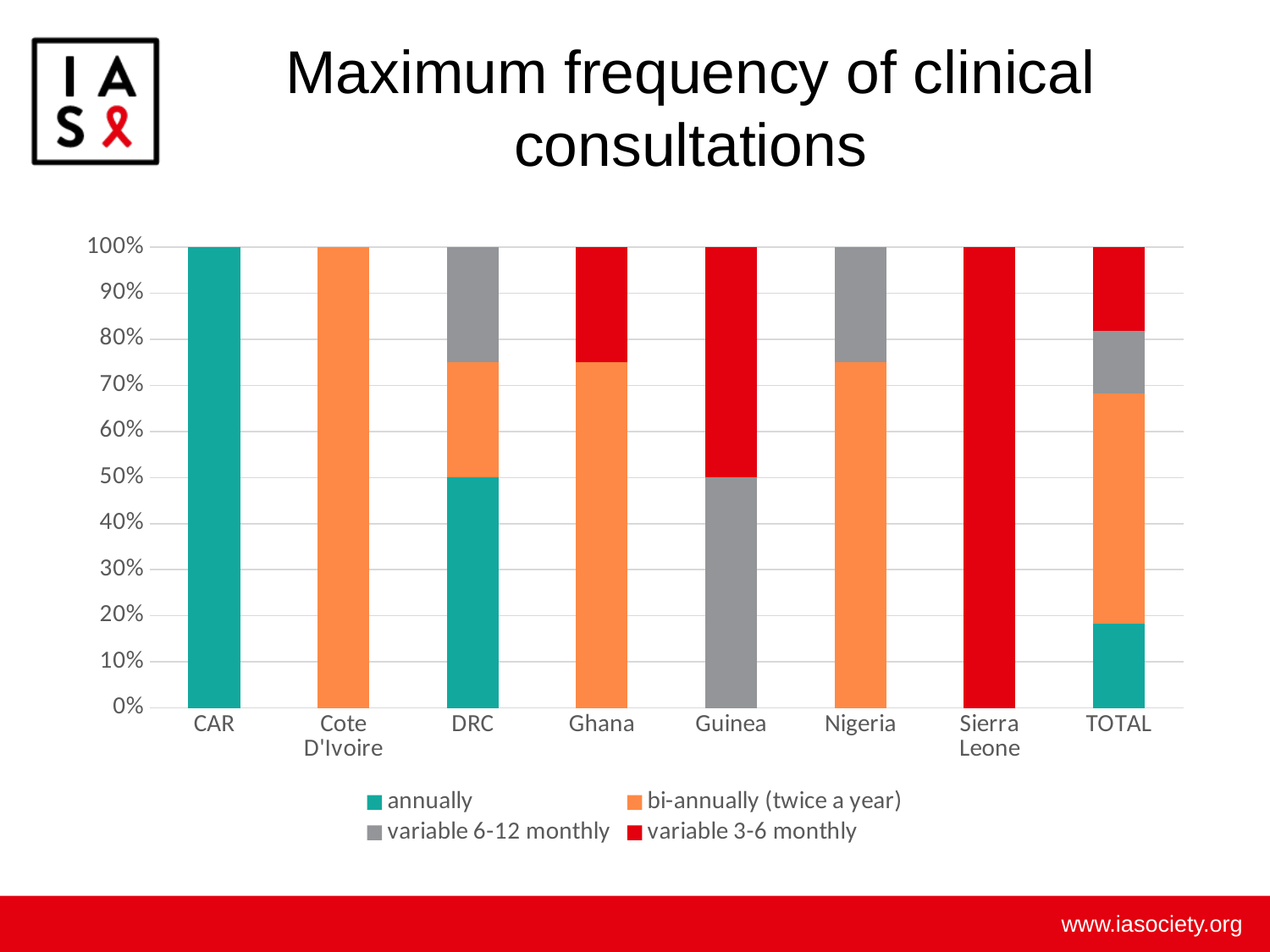
What share of Cote D'Ivoire is 'bi-annually (twice a year)'? 100% What share of Guinea is 'variable 6-12 monthly'? 50% Which country has the larger 'annually' share, CAR or DRC? CAR What kind of chart is shown on the slide? Stacked bar chart What share of DRC is 'annually'? 50% How many categories are shown along the x axis of the chart? 8 Is the 'annually' share for TOTAL greater or less than 20%? less Which series is shown in red in the chart's legend? variable 3-6 monthly How many series does the chart's legend list? 4 What is the title of the chart? Maximum frequency of clinical consultations What share of CAR is 'annually'? 100% What share of Sierra Leone is 'variable 3-6 monthly'? 100%